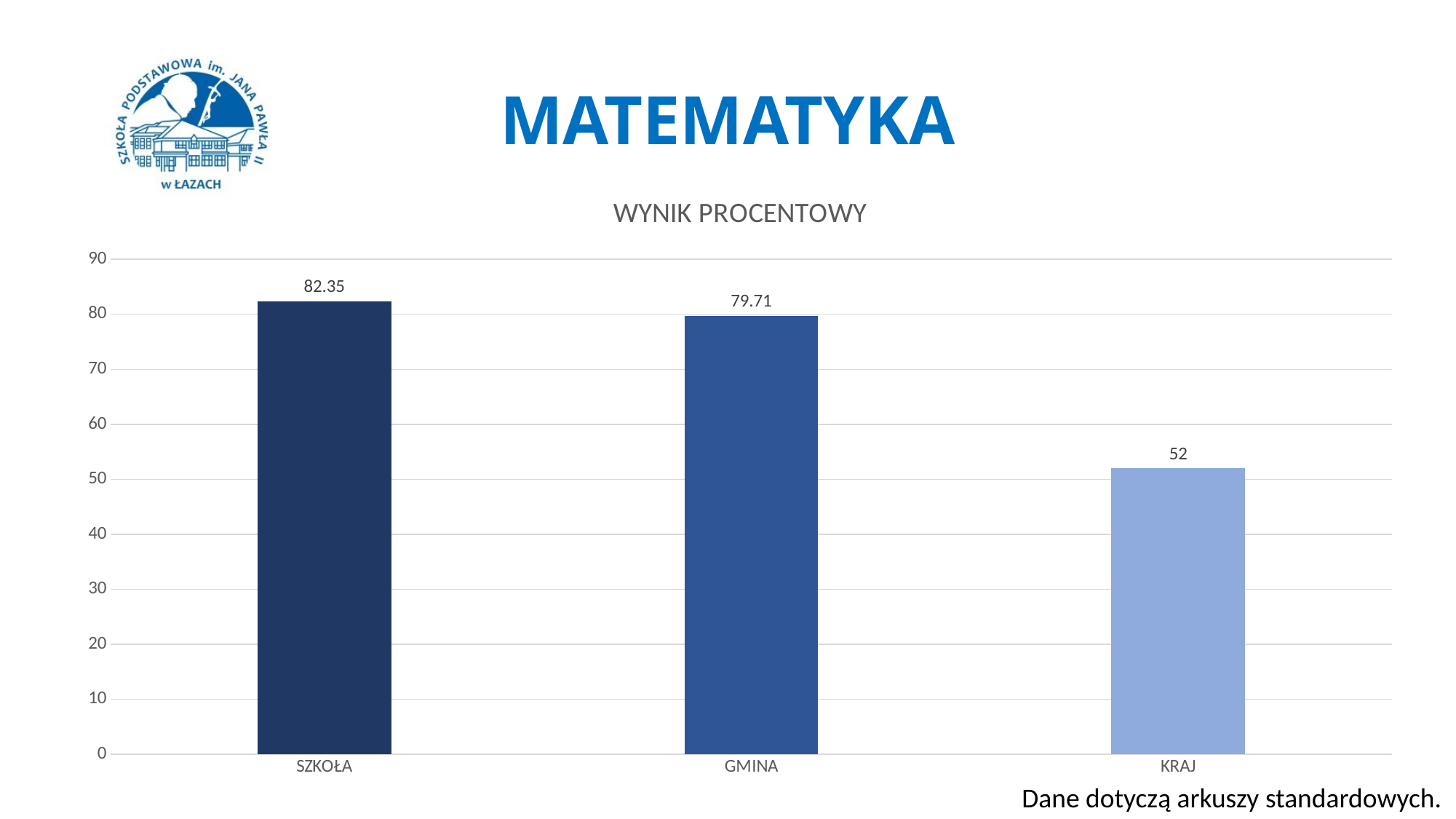
What is the value for KRAJ? 52 What is the difference between the values for SZKOŁA and GMINA? 2.64 What kind of chart is shown on the slide? bar chart Which is larger, the value for GMINA or the value for KRAJ? GMINA What is the value for GMINA? 79.71 Which category has the highest value? SZKOŁA What is the value for SZKOŁA? 82.35 What is the title of the chart? WYNIK PROCENTOWY Is the value for KRAJ greater or less than 60? less How many categories are shown in the chart? 3 Which category has the lowest value? KRAJ What is the difference between the values for SZKOŁA and KRAJ? 30.35